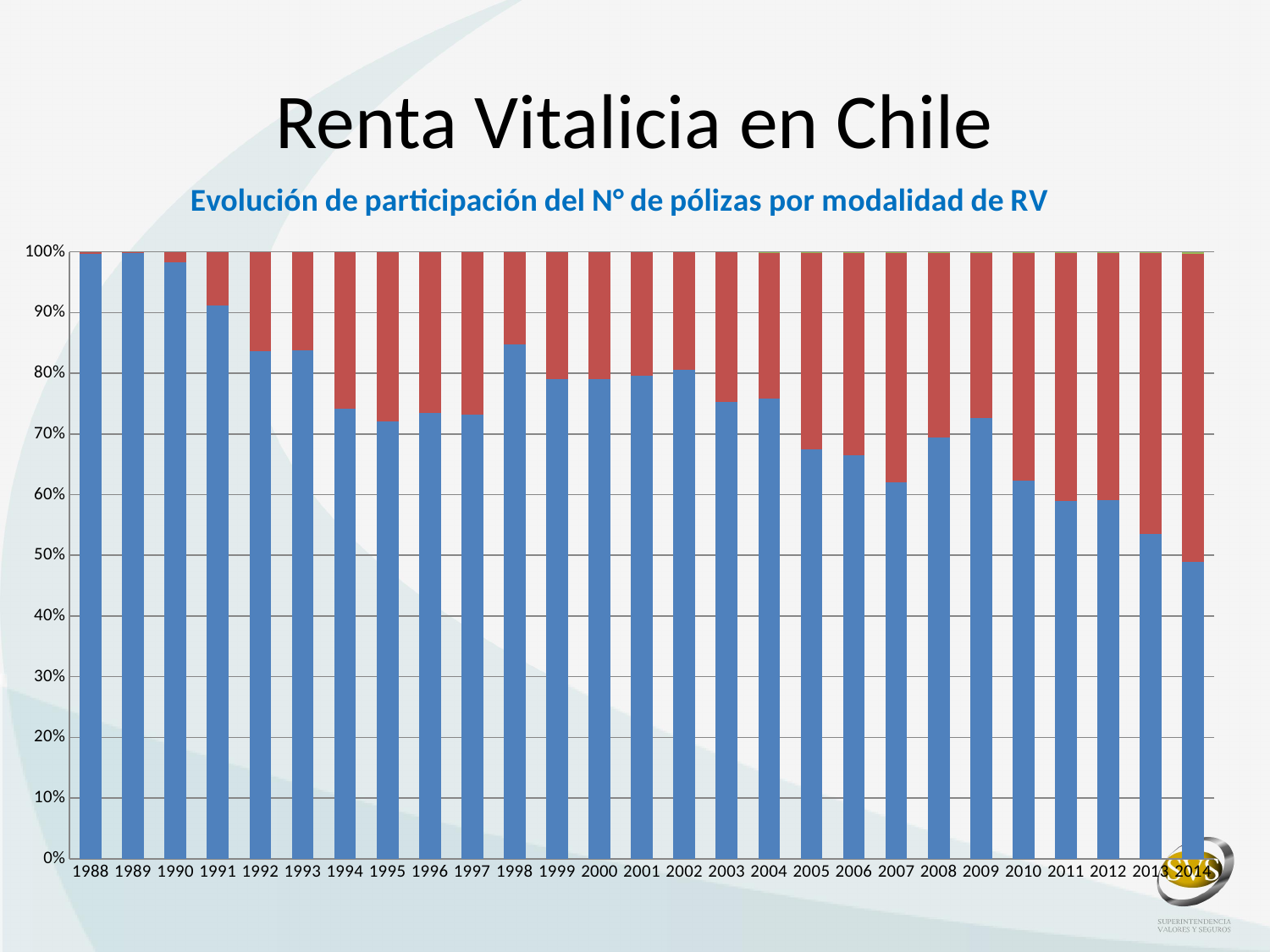
Is the blue segment for 2014 greater or less than 50%? less Is the blue segment for 1991 greater or less than 90%? greater What is the subtitle of the chart? Evolución de participación del N° de pólizas por modalidad de RV In which year is the red segment the largest? 2014 Is the blue segment for 2007 greater or less than 60%? greater In which year is the blue segment the smallest? 2014 Does the blue share generally rise or fall from 1988 to 2014? fall How many years are shown along the x axis of the chart? 27 Which year has a larger blue segment, 1997 or 1998? 1998 What is the title of the slide? Renta Vitalicia en Chile What kind of chart is shown on the slide? Stacked bar chart